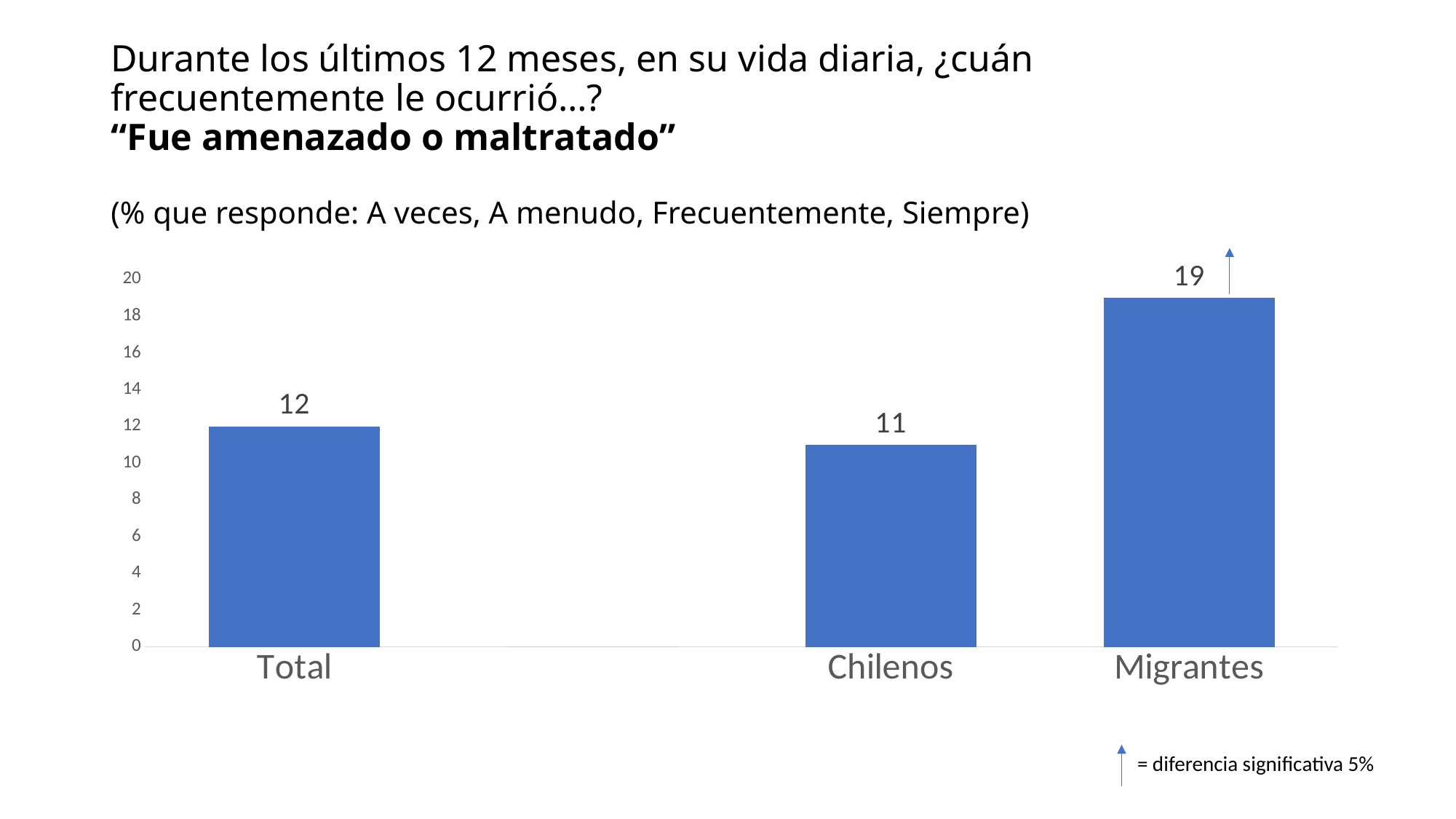
What kind of chart is shown on the slide? bar chart What is the value for Total? 12 Which category has the lowest value? Chilenos How many categories are shown on the x axis? 3 Is the value for Migrantes greater or less than 16? greater Which category has the highest value? Migrantes What is the value for Migrantes? 19 Which is larger, the value for Migrantes or the value for Total? Migrantes What is the difference between the values for Migrantes and Total? 7 What is the difference between the values for Migrantes and Chilenos? 8 What is the value for Chilenos? 11 Which category is marked with an arrow indicating a significant difference at 5%? Migrantes